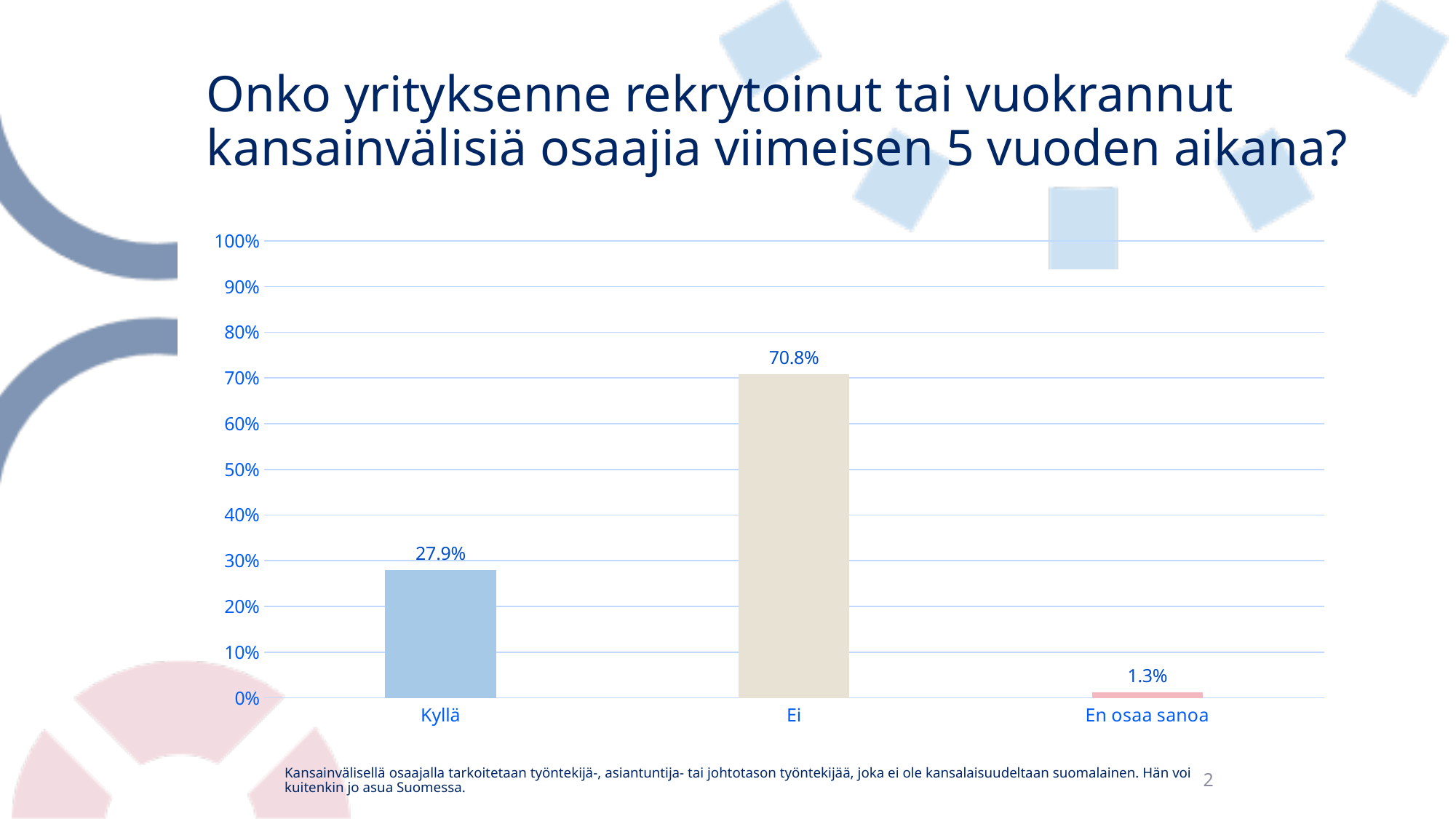
What is the value for Ei? 70.8% What is the difference between the values for Kyllä and En osaa sanoa? 26.6% How many categories are shown on the x axis? 3 What is the value for Kyllä? 27.9% Which is larger, the value for Kyllä or the value for Ei? Ei What is the value for En osaa sanoa? 1.3% Which category has the highest value? Ei Is the value for Ei greater or less than 60%? greater Is the value for Kyllä greater or less than 30%? less What is the difference between the values for Ei and Kyllä? 42.9% Which category has the lowest value? En osaa sanoa What kind of chart is shown on the slide? Bar chart